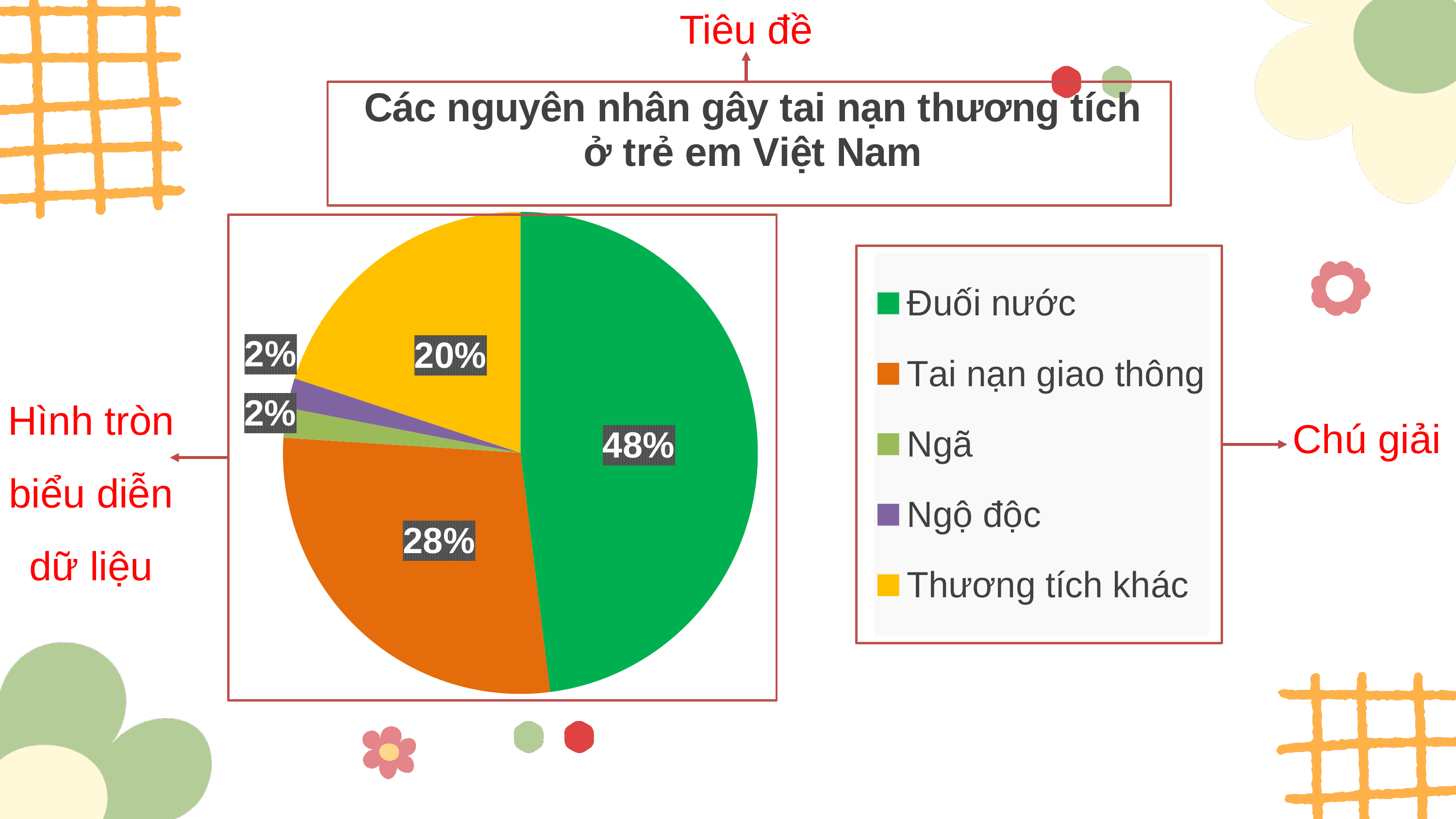
Which is larger, the slice for Thương tích khác or the slice for Tai nạn giao thông? Tai nạn giao thông What is the title of the chart? Các nguyên nhân gây tai nạn thương tích ở trẻ em Việt Nam What percentage is shown for Ngộ độc? 2% What share of the pie does Đuối nước represent? 48% What percentage is shown for Thương tích khác? 20% What kind of chart is shown on the slide? Pie chart Which category has the largest slice of the pie? Đuối nước What colour is the slice for Ngộ độc in the legend? Purple How many categories does the pie chart show? 5 What is the difference in percentage points between Tai nạn giao thông and Thương tích khác? 8 What percentage is shown for Tai nạn giao thông? 28% What is the difference in percentage points between Đuối nước and Tai nạn giao thông? 20